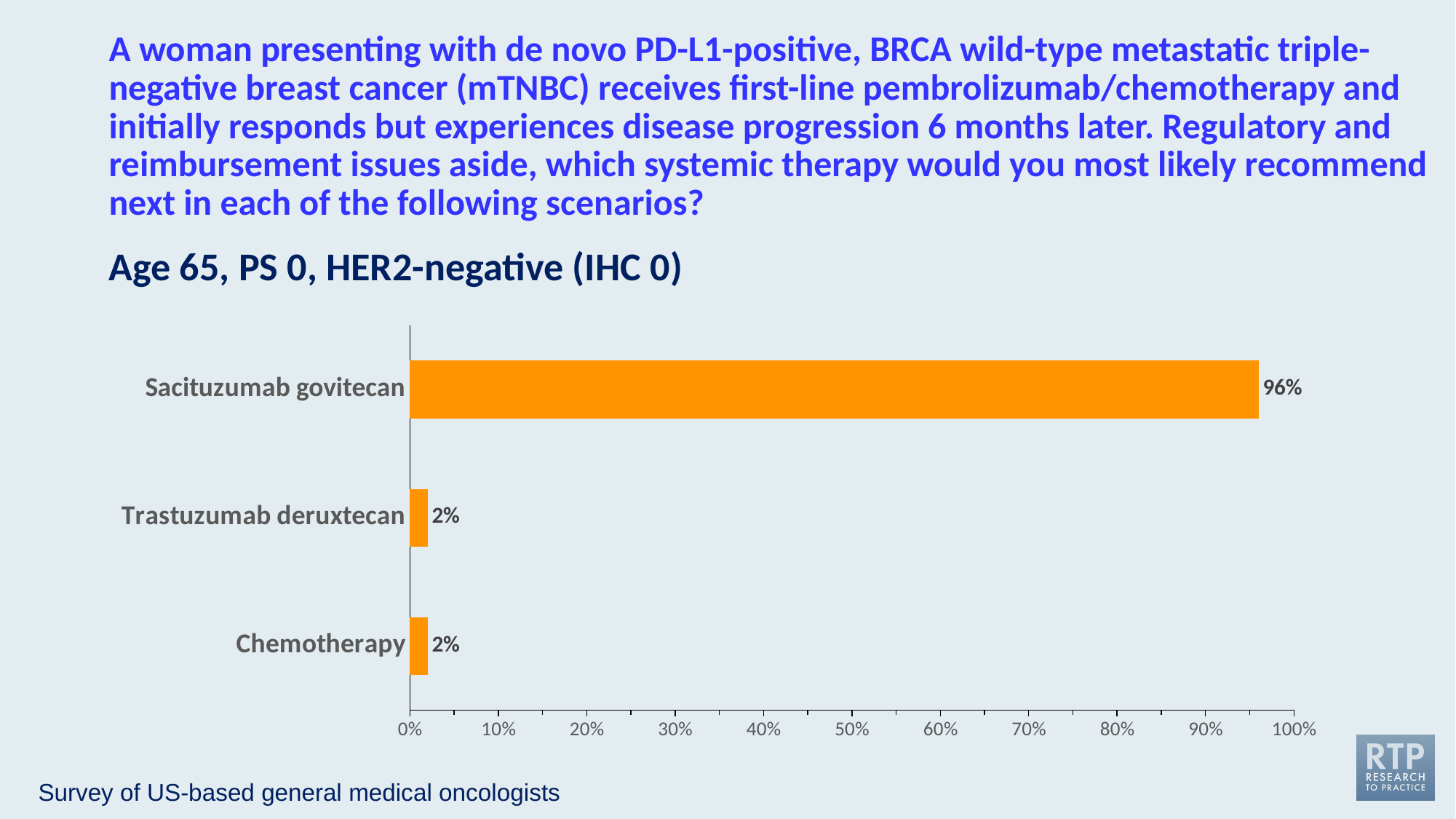
Which has a larger value, Sacituzumab govitecan or Trastuzumab deruxtecan? Sacituzumab govitecan What percentage of respondents chose Trastuzumab deruxtecan? 2% What percentage of respondents chose Sacituzumab govitecan? 96% Is the value for Sacituzumab govitecan greater or less than 90%? greater What is the difference in percentage points between Sacituzumab govitecan and Chemotherapy? 94 Is the value for Chemotherapy greater or less than 10%? less What percentage of respondents chose Chemotherapy? 2% What colour are the bars in the chart? Orange What is the maximum value shown on the x axis? 100% What kind of chart is shown on the slide? Bar chart Which therapy received the highest percentage of responses? Sacituzumab govitecan How many therapy options are shown in the chart? 3